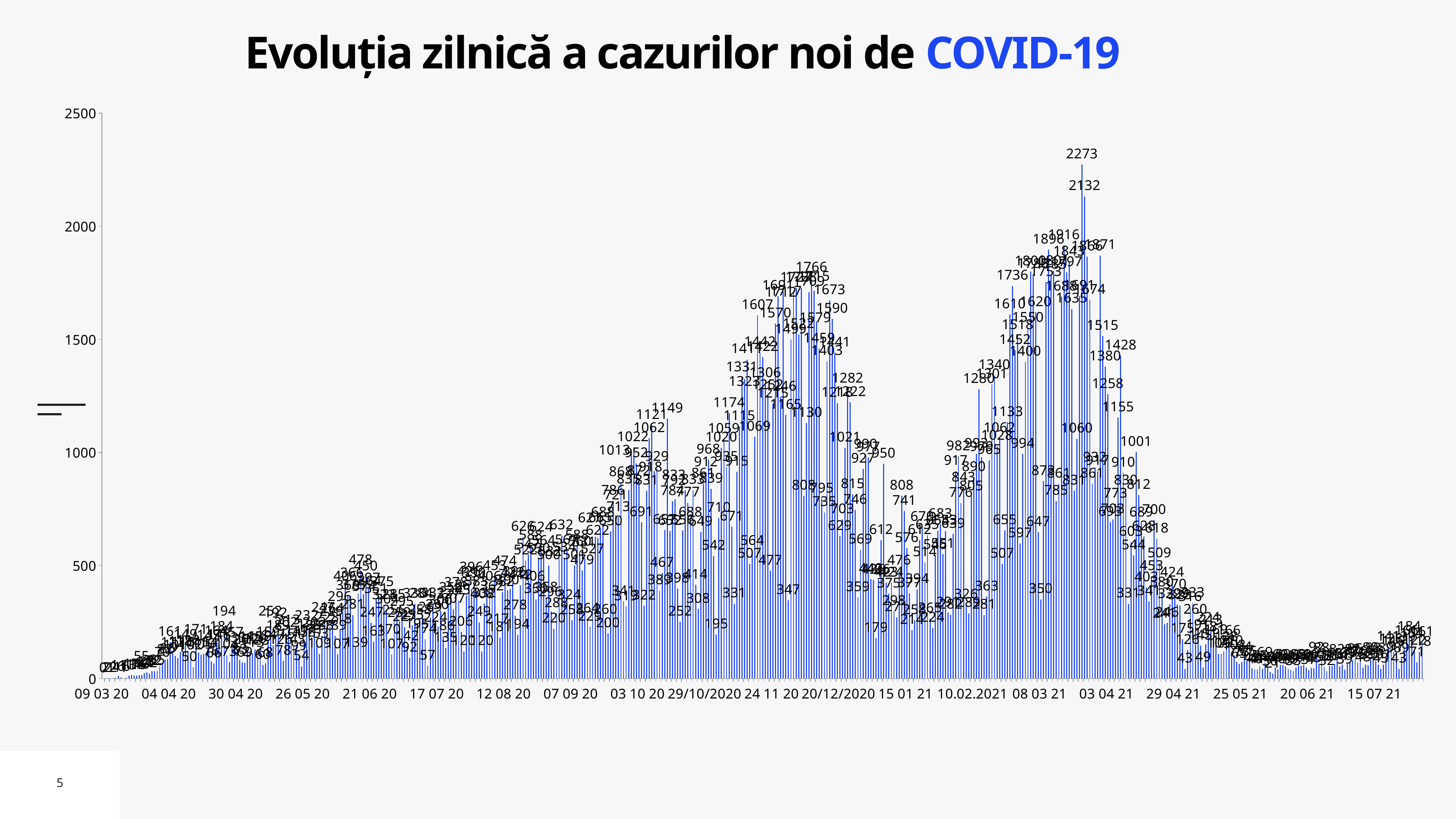
Are the daily values around the x-axis label '20 06 21' greater or less than 500? less What kind of chart is shown on the slide? bar chart What is the difference between the two highest labelled values, 2273 and 2132? 141 What is the highest daily value labelled on the chart? 2273 What is the title of the chart? Evoluția zilnică a cazurilor noi de COVID-19 Which is larger: the peak value of 2273 in spring 2021 or the peak value of 1766 in the late-2020 wave? 2273 What is the highest value shown on the y axis? 2500 What is the last date label on the x axis? 15 07 21 Do the daily values rise or fall between the peak near '03 04 21' and '20 06 21'? fall What is the second-highest daily value labelled on the chart, just below the peak of 2273? 2132 What is the first date label on the x axis? 09 03 20 Is the highest bar on the chart greater or less than 2000? greater